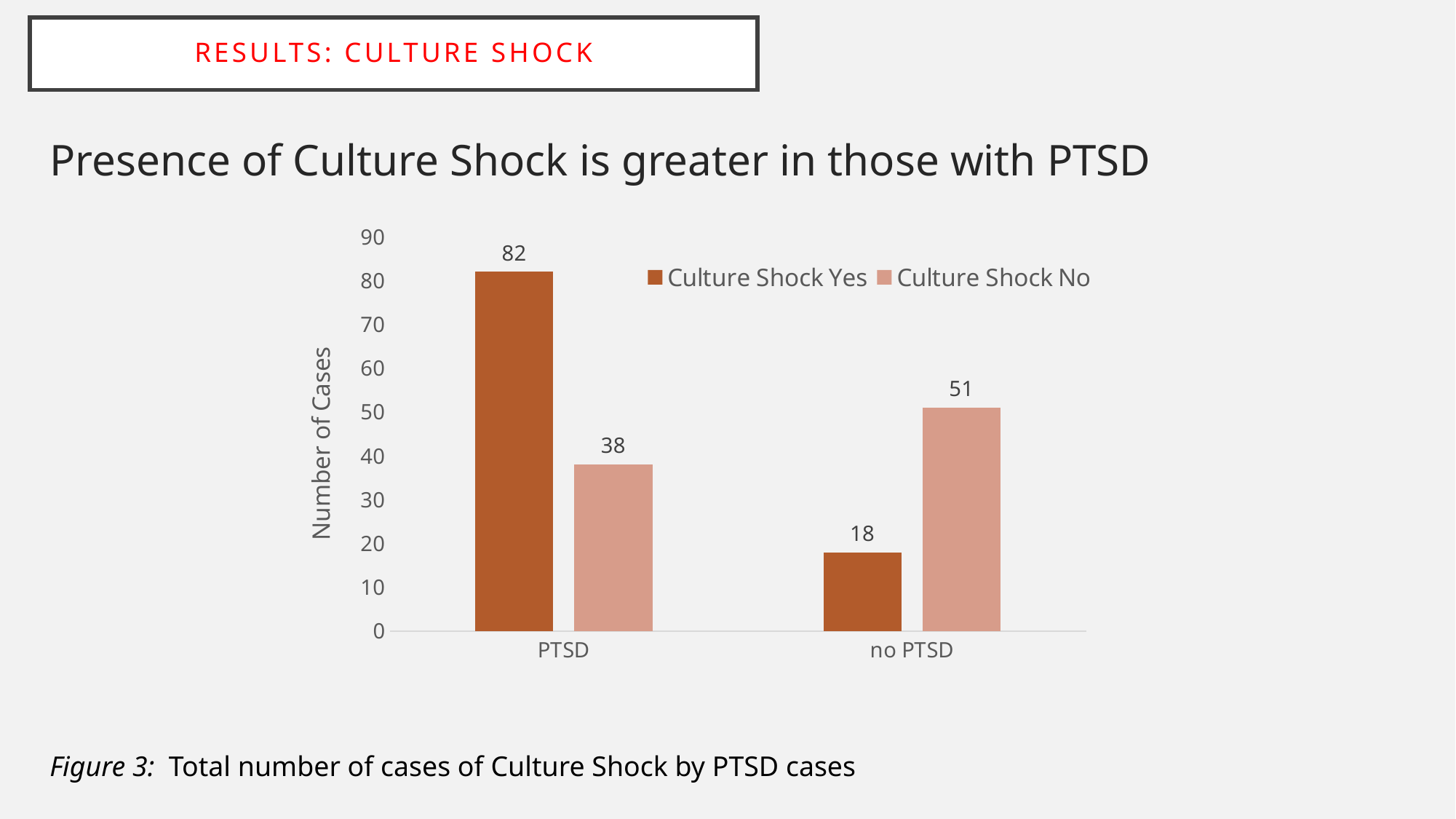
What is the label of the vertical axis? Number of Cases What is the number of cases for Culture Shock Yes in the PTSD group? 82 What is the number of cases for Culture Shock No in the PTSD group? 38 How many series does the legend list? 2 Which is larger in the no PTSD group: Culture Shock Yes or Culture Shock No? Culture Shock No Which bar has the lowest value on the chart? Culture Shock Yes, no PTSD What is the number of cases for Culture Shock No in the no PTSD group? 51 What is the difference between Culture Shock No and Culture Shock Yes in the no PTSD group? 33 What kind of chart is shown on the slide? Bar chart Which bar has the highest value on the chart? Culture Shock Yes, PTSD What is the number of cases for Culture Shock Yes in the no PTSD group? 18 What is the difference between Culture Shock Yes and Culture Shock No in the PTSD group? 44